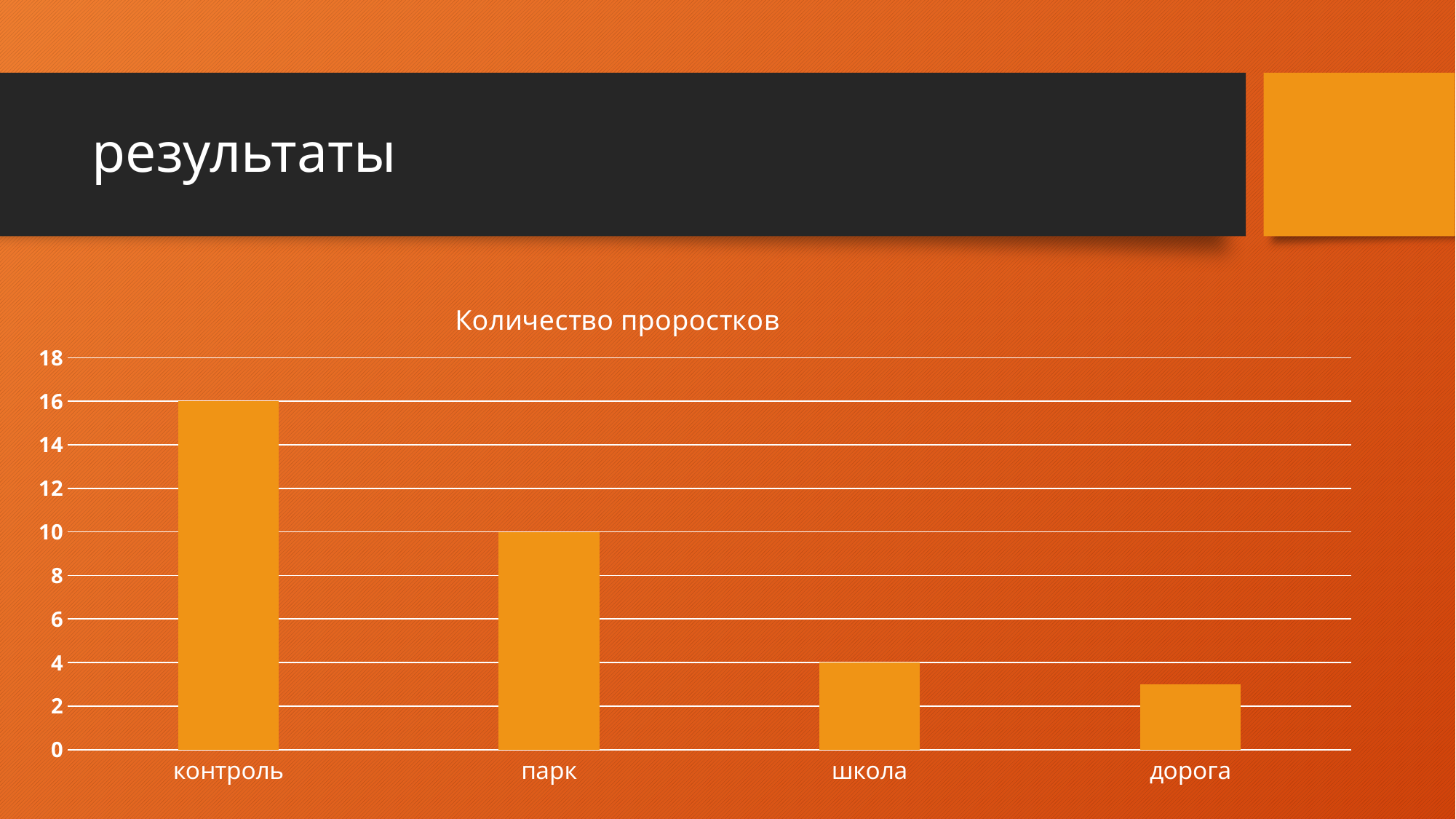
Which category has the highest value? контроль What is the value for контроль? 16 What type of chart is shown on the slide? bar chart What is the title of the chart? Количество проростков Which is larger, the value for парк or the value for школа? парк What is the value for школа? 4 Do the values rise or fall from left to right along the x axis? fall How many categories are shown on the x axis of the chart? 4 Is the value for дорога greater or less than 4? less What is the value for парк? 10 What is the difference between the values for контроль and парк? 6 Which category has the lowest value? дорога